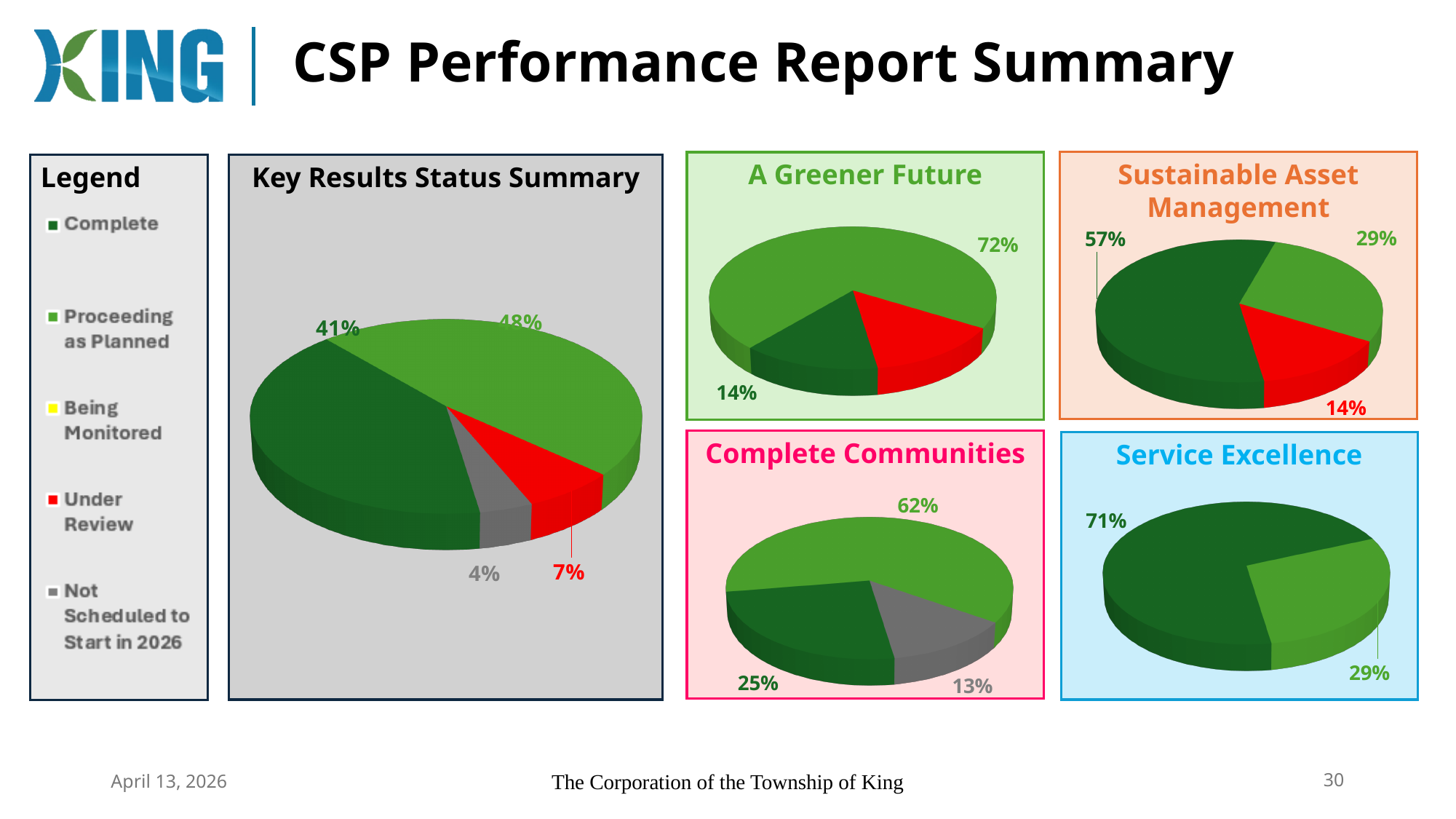
In the Complete Communities chart, what is the share for Not Scheduled to Start in 2026? 13% How many slices does the Service Excellence chart have? 2 In the Key Results Status Summary chart, what percentage of key results are Complete? 41% What type of chart is used for the Key Results Status Summary? Pie chart In the Key Results Status Summary chart, which status has the smallest share? Not Scheduled to Start in 2026 In the Sustainable Asset Management chart, what is the share for Under Review? 14% In the Complete Communities chart, what is the difference between the Proceeding as Planned share and the Complete share? 37% In the Sustainable Asset Management chart, what is the share for Complete? 57% In the A Greener Future chart, what is the share for Proceeding as Planned? 72% In the Service Excellence chart, which is larger, the Complete share or the Proceeding as Planned share? Complete In the Key Results Status Summary chart, what percentage of key results are Proceeding as Planned? 48% In the Key Results Status Summary chart, what percentage of key results are Under Review? 7%